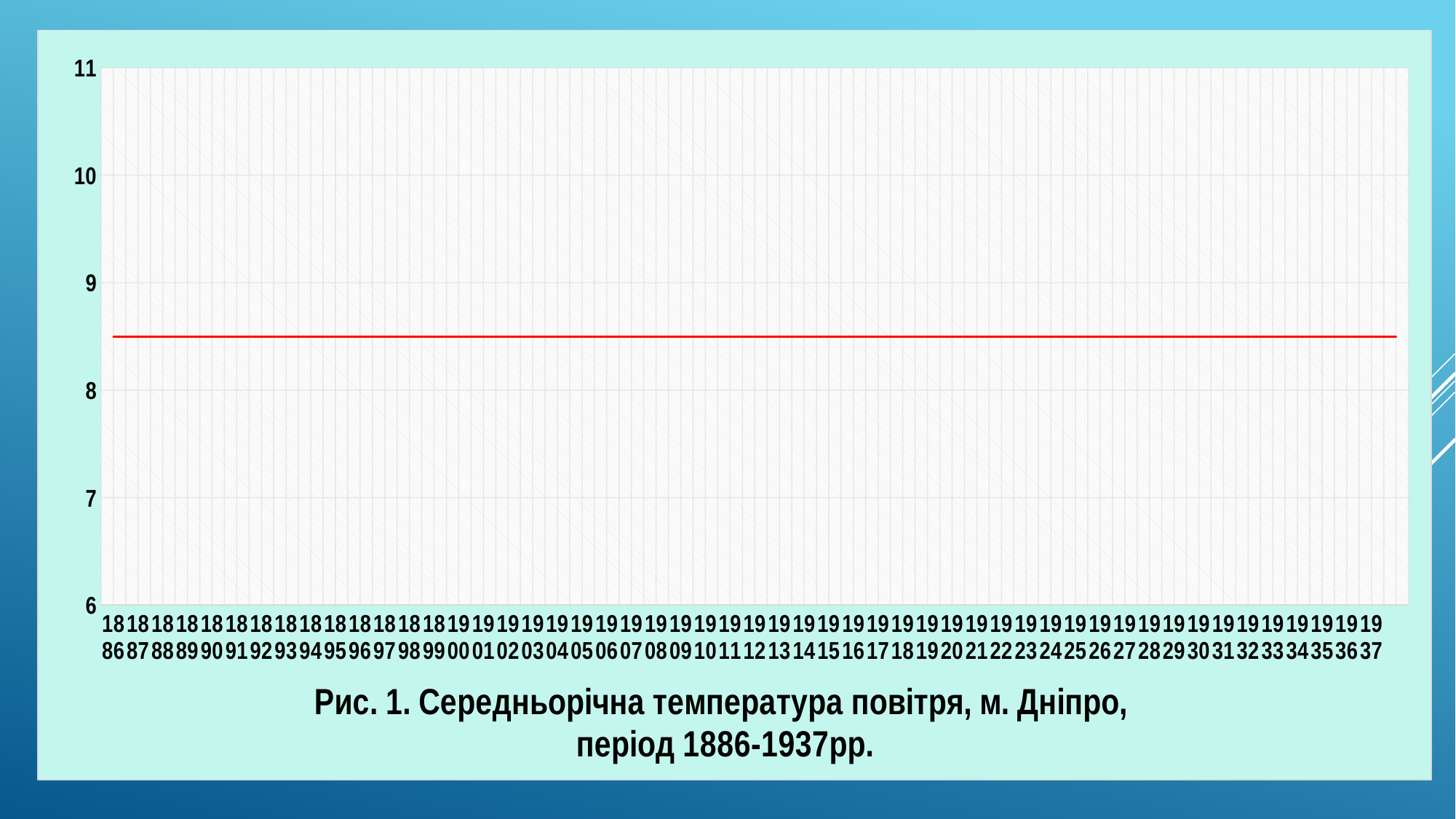
Do the values rise, fall, or stay flat from 1886 to 1937? stay flat What is the first year shown on the x axis? 1886 What is the title of the chart? Рис. 1. Середньорічна температура повітря, м. Дніпро, період 1886-1937рр. Is the value for 1937 greater or less than 9? less Is the value for 1910 greater or less than 10? less What is the highest value shown on the y axis? 11 Is the value for 1925 greater or less than 7? greater How many years are shown on the x axis? 52 What kind of chart is shown on the slide? line chart